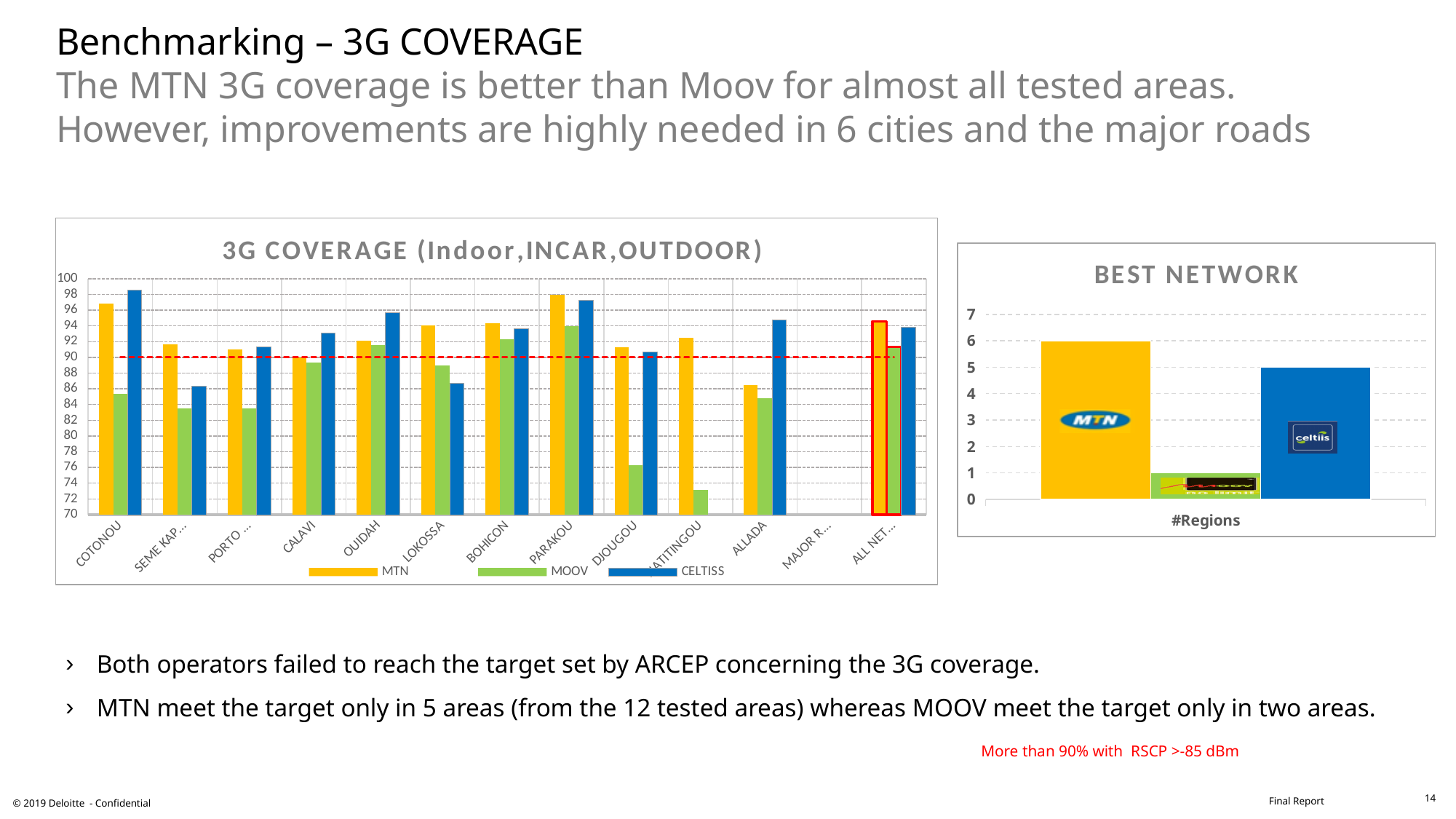
How many series does the legend of the "3G COVERAGE (Indoor,INCAR,OUTDOOR)" chart list? 3 How many categories are shown on the x axis of the "3G COVERAGE (Indoor,INCAR,OUTDOOR)" chart? 13 In the "BEST NETWORK" chart, which network has the highest number of regions? MTN What kind of chart is the "3G COVERAGE (Indoor,INCAR,OUTDOOR)" chart? bar chart In the "3G COVERAGE (Indoor,INCAR,OUTDOOR)" chart, which is larger for ALLADA: MTN or CELTISS? CELTISS In the "3G COVERAGE (Indoor,INCAR,OUTDOOR)" chart, which is larger for COTONOU: MTN or MOOV? MTN In the "3G COVERAGE (Indoor,INCAR,OUTDOOR)" chart, is the MTN value for COTONOU greater or less than 90? greater In the "BEST NETWORK" chart, what is the difference in regions between MTN and Celtiis? 1 In the "BEST NETWORK" chart, which network has the lowest number of regions? MOOV In the "3G COVERAGE (Indoor,INCAR,OUTDOOR)" chart, is the MOOV value for DJOUGOU greater or less than 80? less In the "BEST NETWORK" chart, what is the number of regions for MTN? 6 In the "3G COVERAGE (Indoor,INCAR,OUTDOOR)" chart, is the MOOV value for PARAKOU greater or less than 90? greater